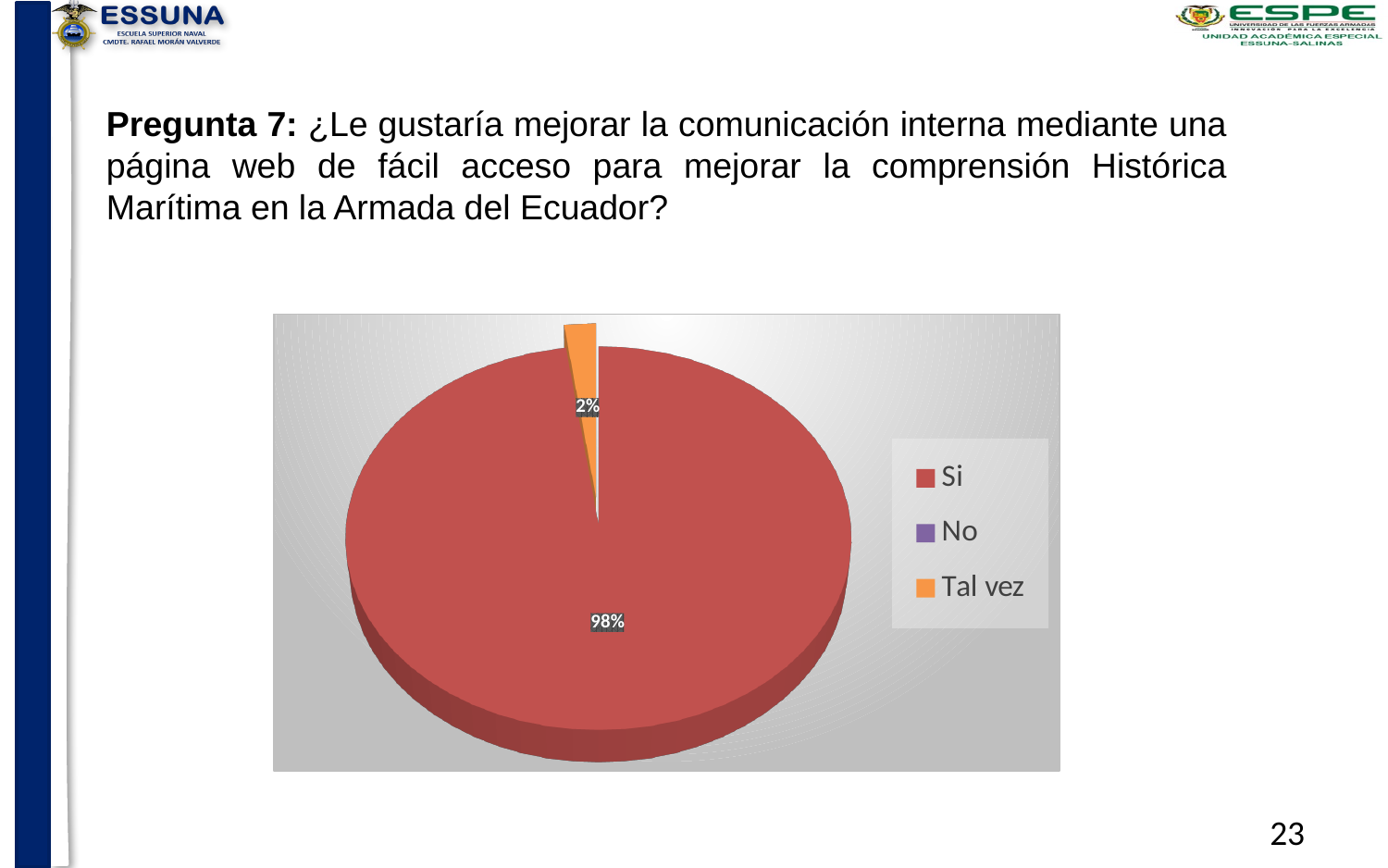
What percentage of the pie does the "Tal vez" slice represent? 2% Is the share for "Si" greater or less than 50%? greater What percentage of the pie does the "Si" slice represent? 98% What is the difference in percentage points between the "Si" slice and the "Tal vez" slice? 96 What kind of chart is shown on the slide? pie chart What colour is the "Tal vez" slice in the pie chart? orange What colour is the "Si" slice in the pie chart? red Which category has the largest share of the pie? Si How many entries does the legend list? 3 Which of the two labelled slices is larger, "Si" or "Tal vez"? Si